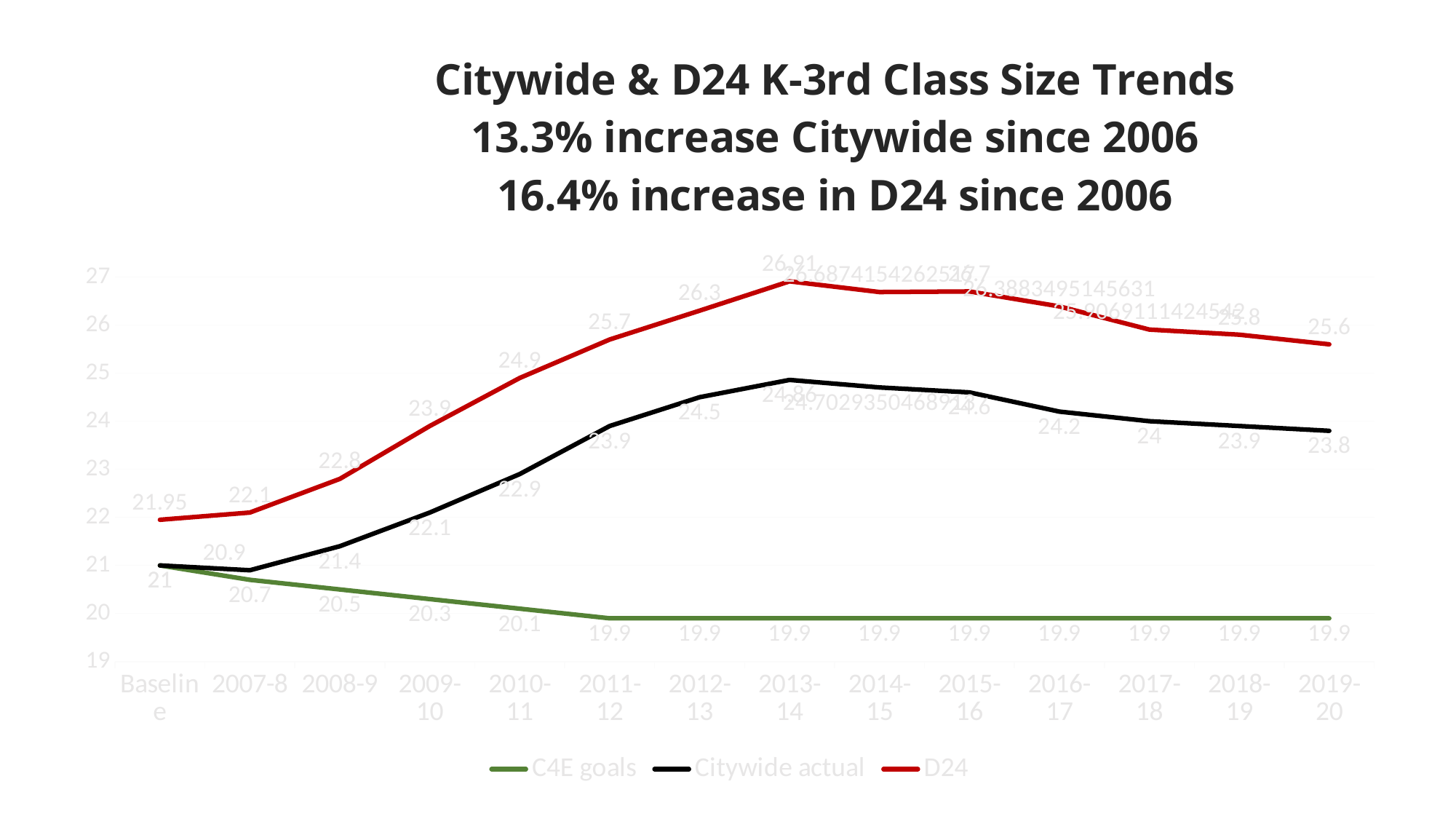
What is the Citywide actual value for 2011-12? 23.9 In 2012-13, which is larger: the D24 value or the Citywide actual value? D24 How many series does the legend list? 3 What is the difference between the D24 and Citywide actual values in 2019-20? 1.8 How many points along the x axis does the chart have? 14 What is the Citywide actual value for 2013-14? 24.86 What is the C4E goals value for 2019-20? 19.9 In which year does the D24 series reach its highest value? 2013-14 Does the D24 series rise or fall from Baseline to 2013-14? rise Is the Citywide actual value for 2008-9 greater or less than 22? less What is the D24 value at Baseline? 21.95 What kind of chart is shown on the slide? line chart